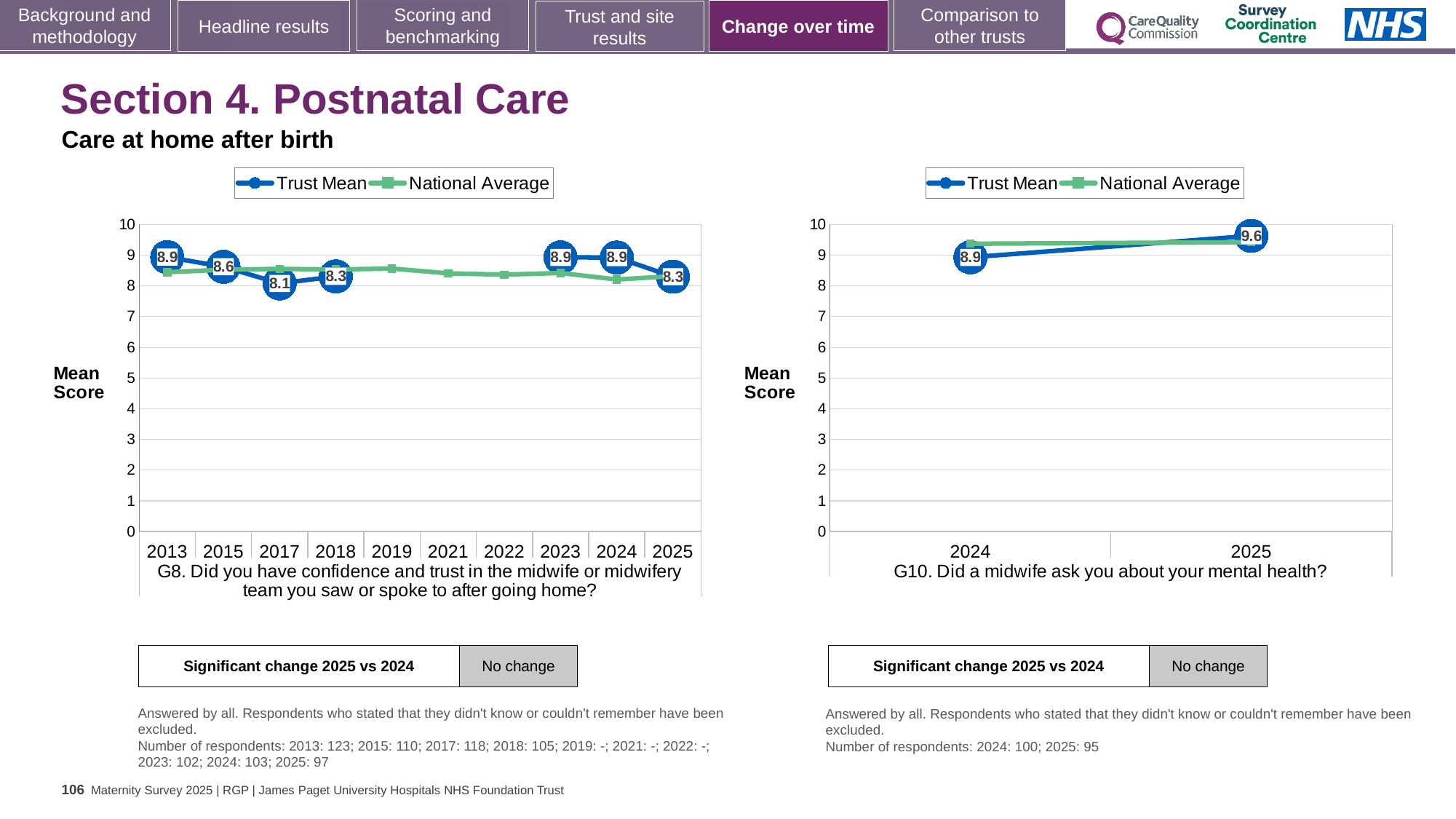
In the G8 chart on the left, what is the Trust Mean score for 2025? 8.3 In the G10 chart on the right, what is the Trust Mean score for 2025? 9.6 How many series does the legend of the G8 chart on the left list? 2 In the G8 chart on the left, by how much did the Trust Mean score fall from 2024 to 2025? 0.6 In the G8 chart on the left, which is larger: the Trust Mean for 2013 or for 2025? 2013 In the G10 chart on the right, what is the difference between the Trust Mean scores for 2025 and 2024? 0.7 In the G8 chart on the left, what is the Trust Mean score for 2017? 8.1 In the G10 chart on the right, what is the Trust Mean score for 2024? 8.9 In the G10 chart on the right, does the Trust Mean rise or fall from 2024 to 2025? rise In the G8 chart on the left, which year has the lowest Trust Mean score? 2017 In the G8 chart on the left, is the National Average for 2013 greater or less than 8? greater What kind of chart is the G10 chart on the right? line chart